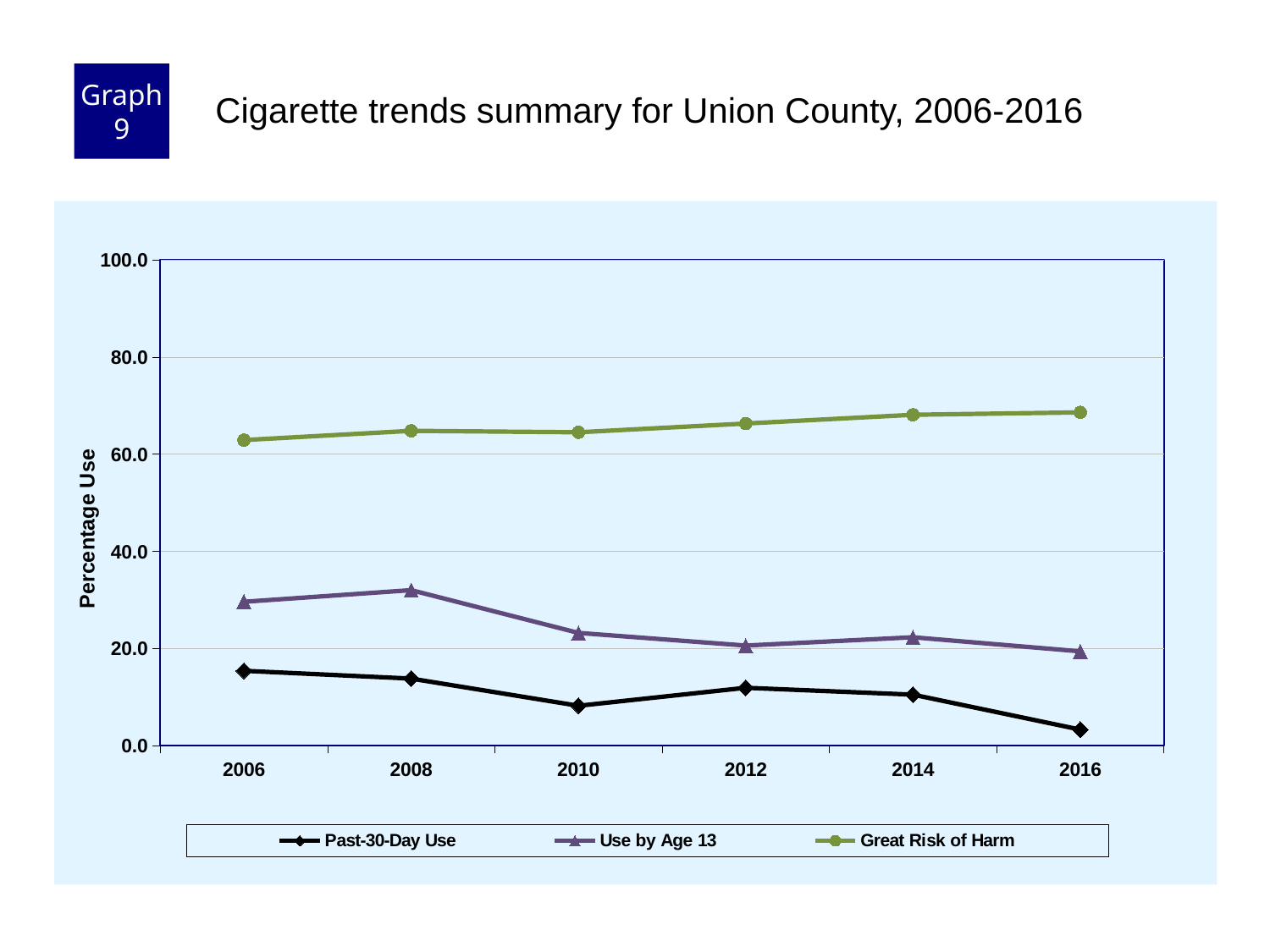
Does the Great Risk of Harm line rise or fall from 2006 to 2016? rise Is the value for Use by Age 13 in 2008 greater or less than 40.0? less How many series does the legend list? 3 Which series has the highest value in 2016? Great Risk of Harm How many years are plotted along the x axis? 6 What is the label on the y axis? Percentage Use In which year is Past-30-Day Use at its lowest? 2016 Which is larger in 2010, Use by Age 13 or Past-30-Day Use? Use by Age 13 Is the value for Great Risk of Harm in 2016 greater or less than 60.0? greater Is the value for Past-30-Day Use in 2016 greater or less than 20.0? less What kind of chart is shown on the slide? line chart Does the Past-30-Day Use line rise or fall overall from 2006 to 2016? fall